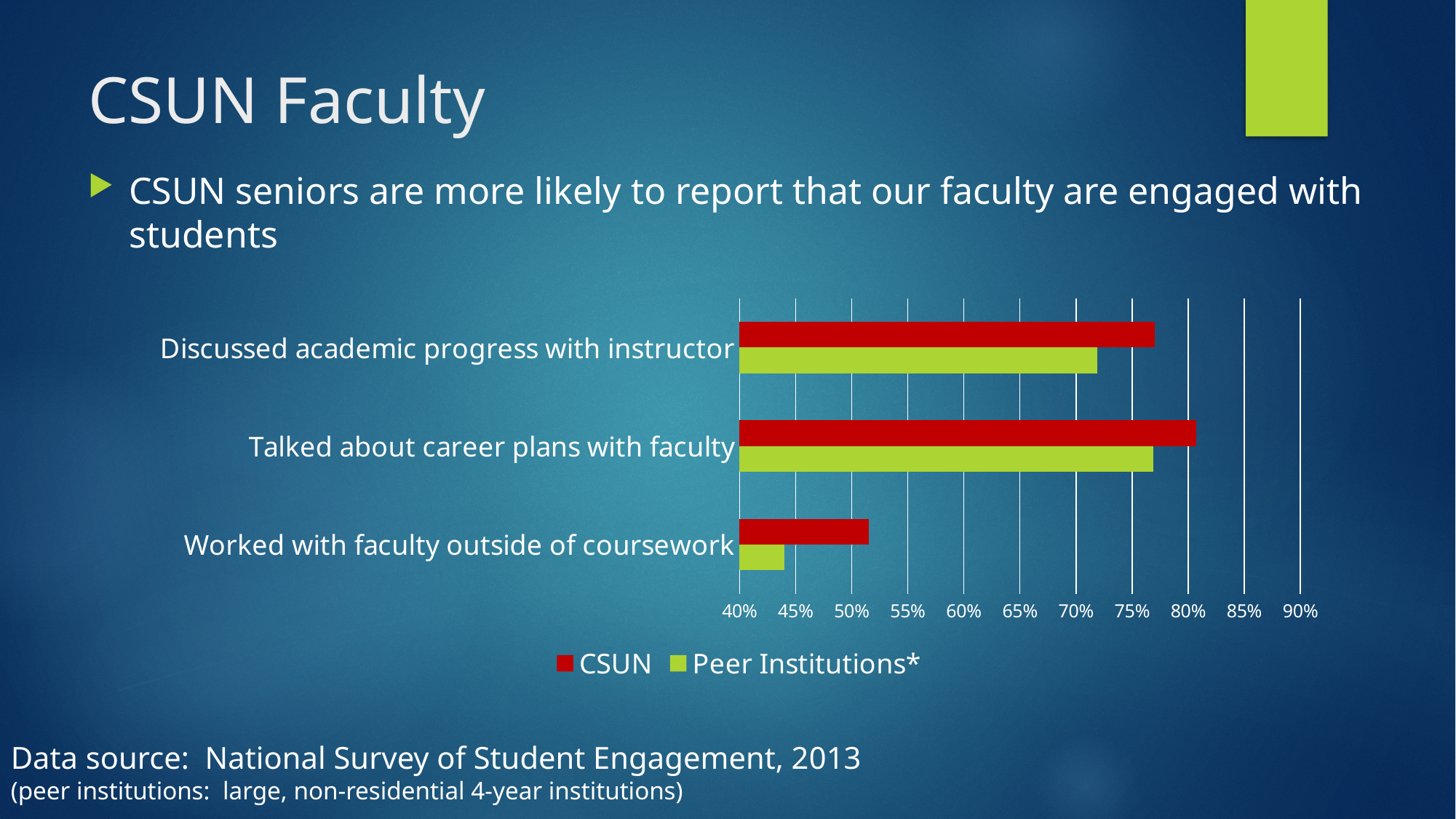
How many series does the chart legend list? 2 Is the CSUN value for 'Discussed academic progress with instructor' greater or less than 75%? greater For 'Worked with faculty outside of coursework', which is larger: CSUN or Peer Institutions*? CSUN What kind of chart is shown on the slide? bar chart Is the CSUN value for 'Worked with faculty outside of coursework' greater or less than 50%? greater Which category has the lowest Peer Institutions* value? Worked with faculty outside of coursework Is the Peer Institutions* value for 'Discussed academic progress with instructor' greater or less than 75%? less Which category has the highest CSUN value? Talked about career plans with faculty For 'Discussed academic progress with instructor', which is larger: CSUN or Peer Institutions*? CSUN How many categories are shown on the chart? 3 Which colour represents the CSUN series in the chart? red